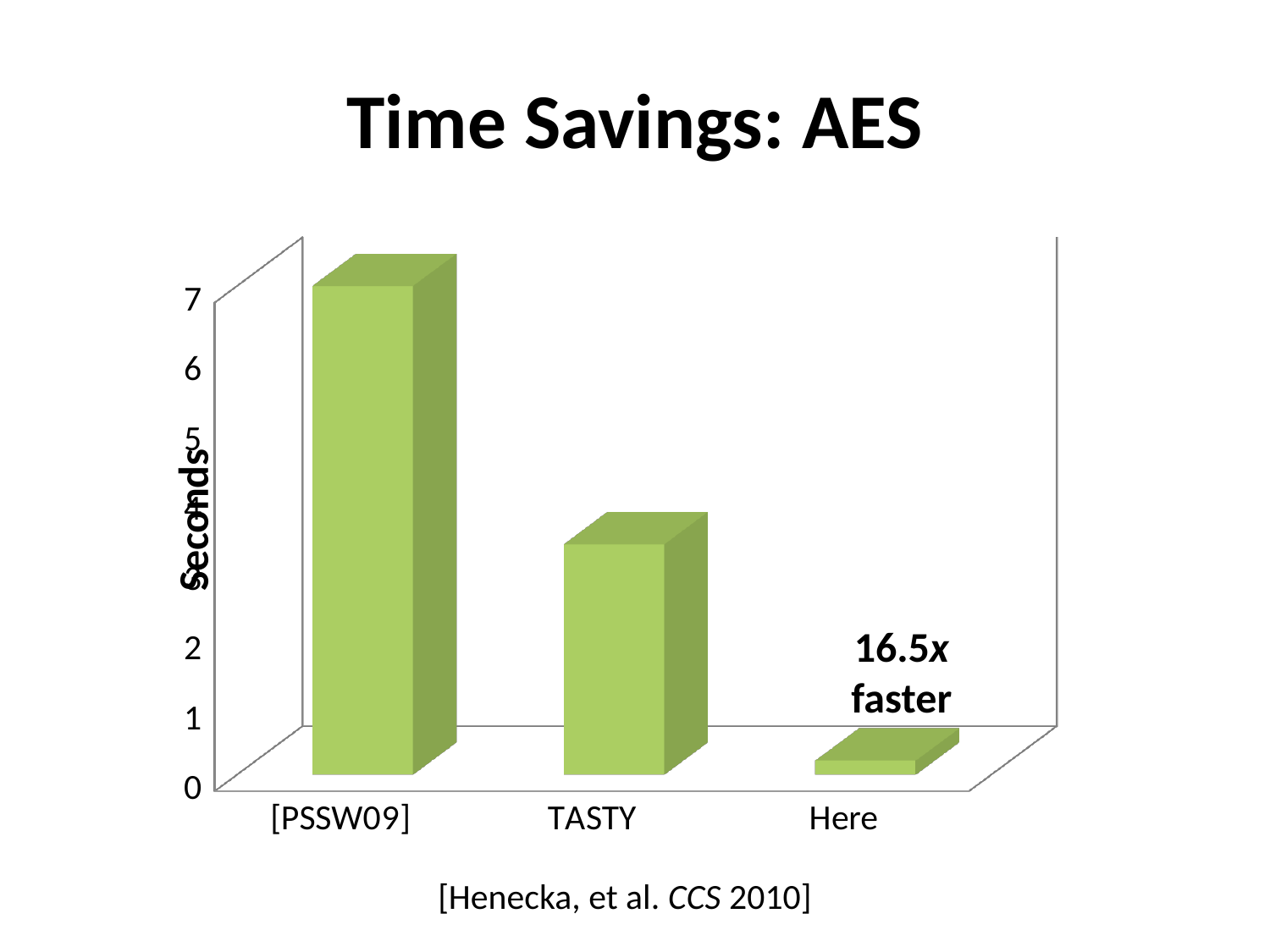
What label is shown on the vertical axis of the chart? Seconds Is the value for TASTY greater or less than 5? less Do the values rise or fall from left to right across the categories? fall Is the value for Here greater or less than 1? less Which category has the highest value in the chart? [PSSW09] How many categories are shown on the x axis of the chart? 3 Which category has the lowest value in the chart? Here Which has a larger value, [PSSW09] or TASTY? [PSSW09] What is the title of the chart on the slide? Time Savings: AES Is the value for [PSSW09] greater or less than 6? greater Which has a larger value, TASTY or Here? TASTY What kind of chart is shown on the slide? bar chart